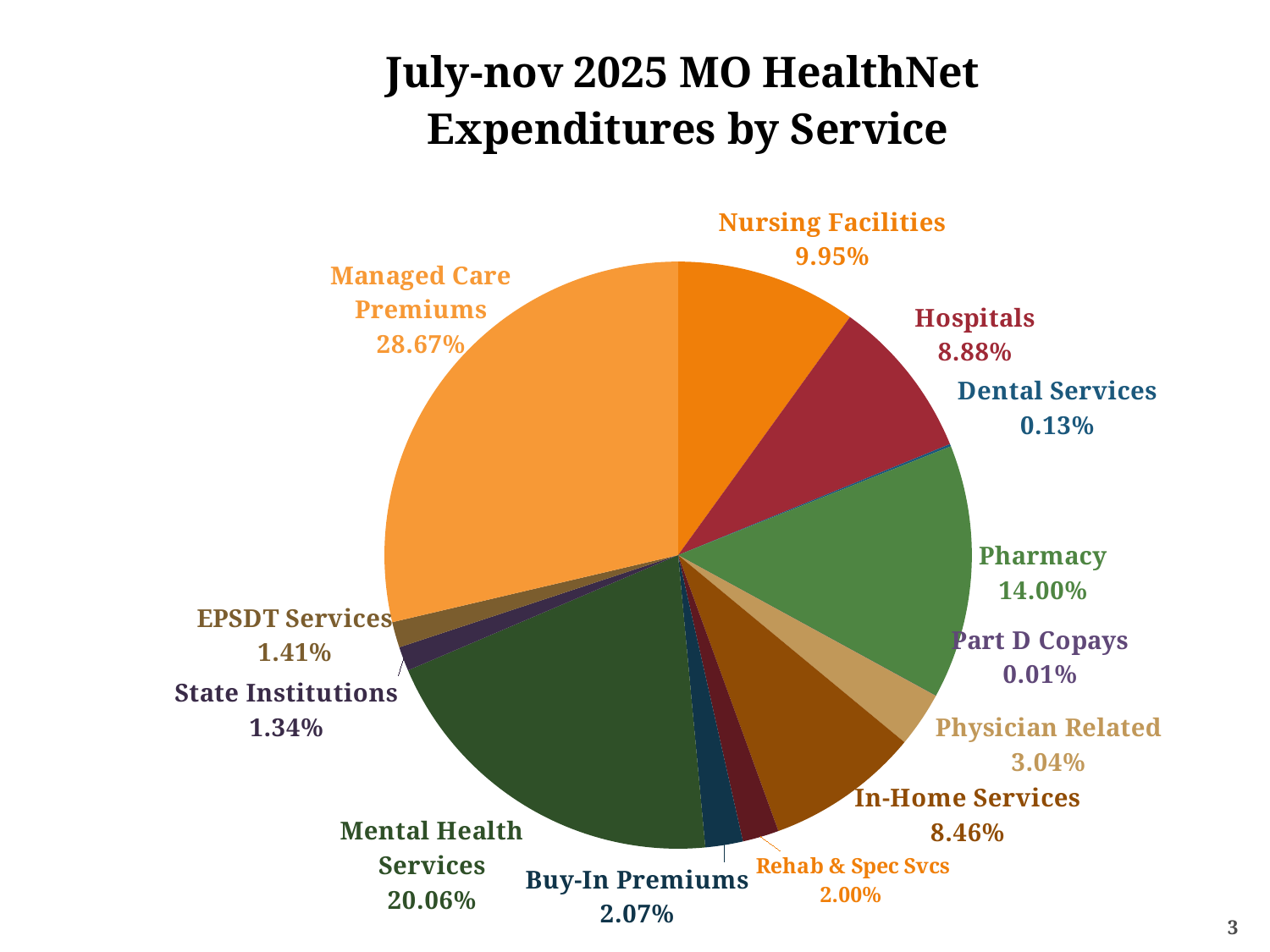
What is the difference between the Buy-In Premiums share and the Rehab & Spec Svcs share? 0.07% What percentage is shown for Pharmacy? 14.00% What type of chart is shown on the slide? pie chart What is the difference between the Mental Health Services share and the Pharmacy share? 6.06% What percentage is shown for Dental Services? 0.13% What percentage is shown for In-Home Services? 8.46% What is the title of the chart? July-nov 2025 MO HealthNet Expenditures by Service Which service category has the largest share of expenditures? Managed Care Premiums What share of expenditures is Managed Care Premiums? 28.67% How many service categories are shown in the pie chart? 13 Which service category has the smallest share of expenditures? Part D Copays Which is larger, the share for Nursing Facilities or the share for Hospitals? Nursing Facilities